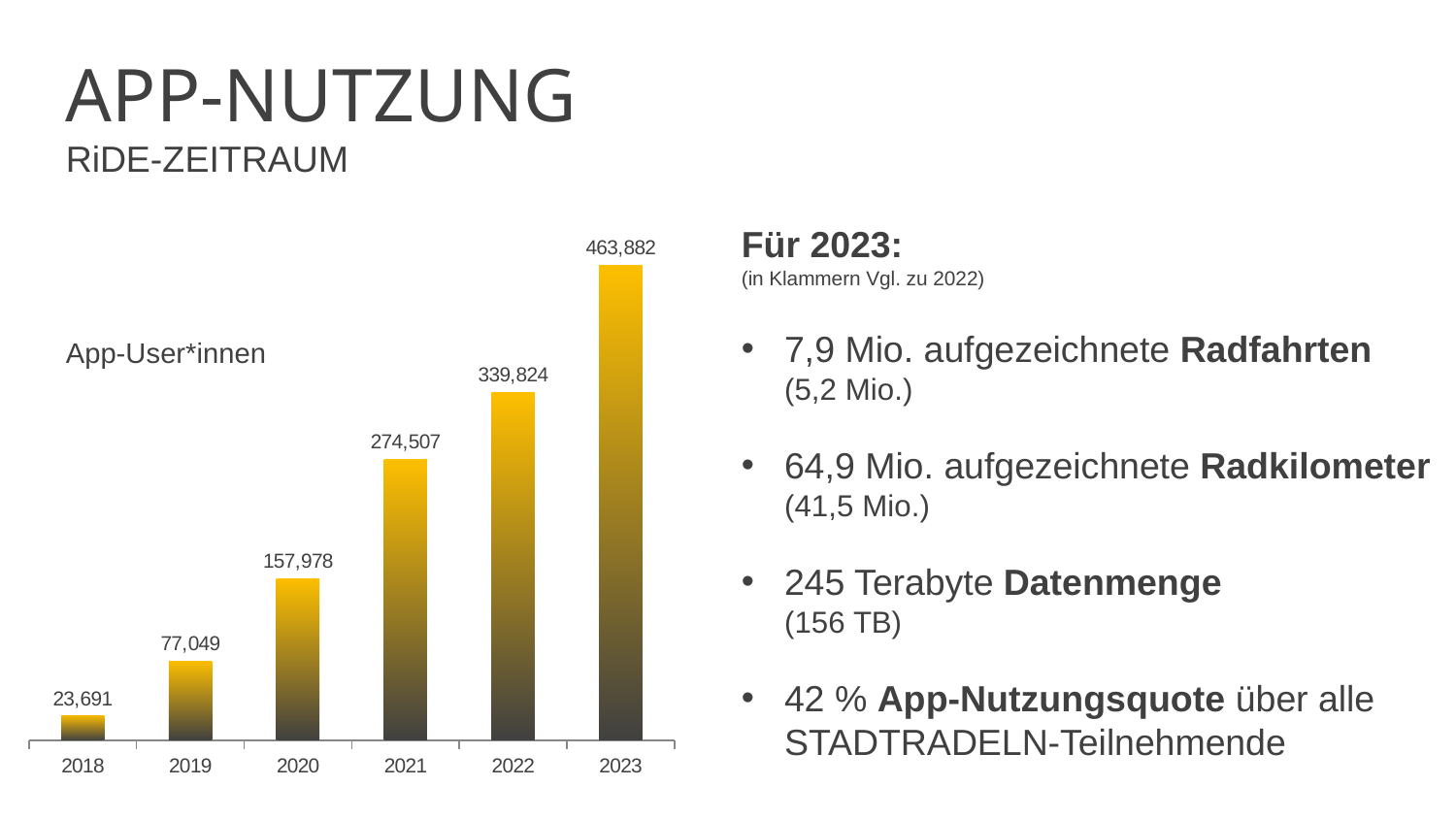
Which year has the lowest number of App-User*innen? 2018 What is the value shown for 2021? 274,507 Which year has a larger value, 2021 or 2022? 2022 What is the number of App-User*innen shown for 2023? 463,882 What is the difference between the values for 2019 and 2018? 53,358 By how much did the number of App-User*innen increase from 2022 to 2023? 124,058 Which year has the highest number of App-User*innen? 2023 Do the values rise or fall from 2018 to 2023? Rise What is the value labelled on the bar for 2020? 157,978 What kind of chart is shown on the slide? Bar chart How many years are shown on the x axis of the chart? 6 What value does the bar for 2018 show? 23,691